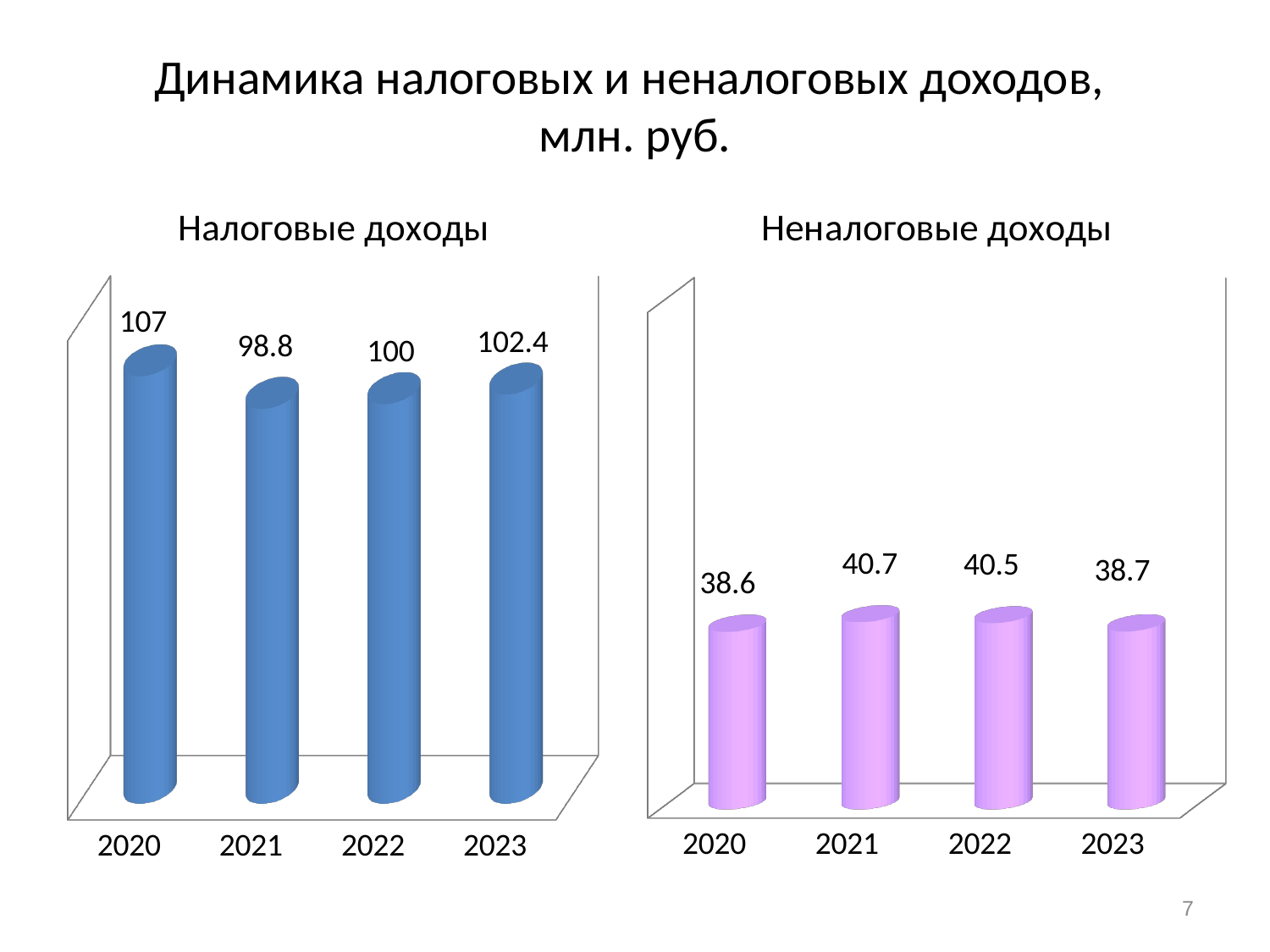
In the 'Неналоговые доходы' chart, what is the value for 2023? 38.7 In the 'Неналоговые доходы' chart, which year has the lowest value? 2020 In the 'Налоговые доходы' chart, what is the value for 2021? 98.8 In the 'Неналоговые доходы' chart, what is the difference between the values for 2021 and 2020? 2.1 How many years are shown in the 'Неналоговые доходы' chart? 4 In the 'Неналоговые доходы' chart, what is the value for 2022? 40.5 In the 'Налоговые доходы' chart, what is the difference between the values for 2020 and 2021? 8.2 What kind of chart is the 'Налоговые доходы' chart? Bar chart In the 'Налоговые доходы' chart, which year has the lowest value? 2021 In the 'Налоговые доходы' chart, what is the value for 2020? 107 In the 'Налоговые доходы' chart, which year has the highest value? 2020 In the 'Налоговые доходы' chart, which is larger: the value for 2022 or the value for 2023? 2023